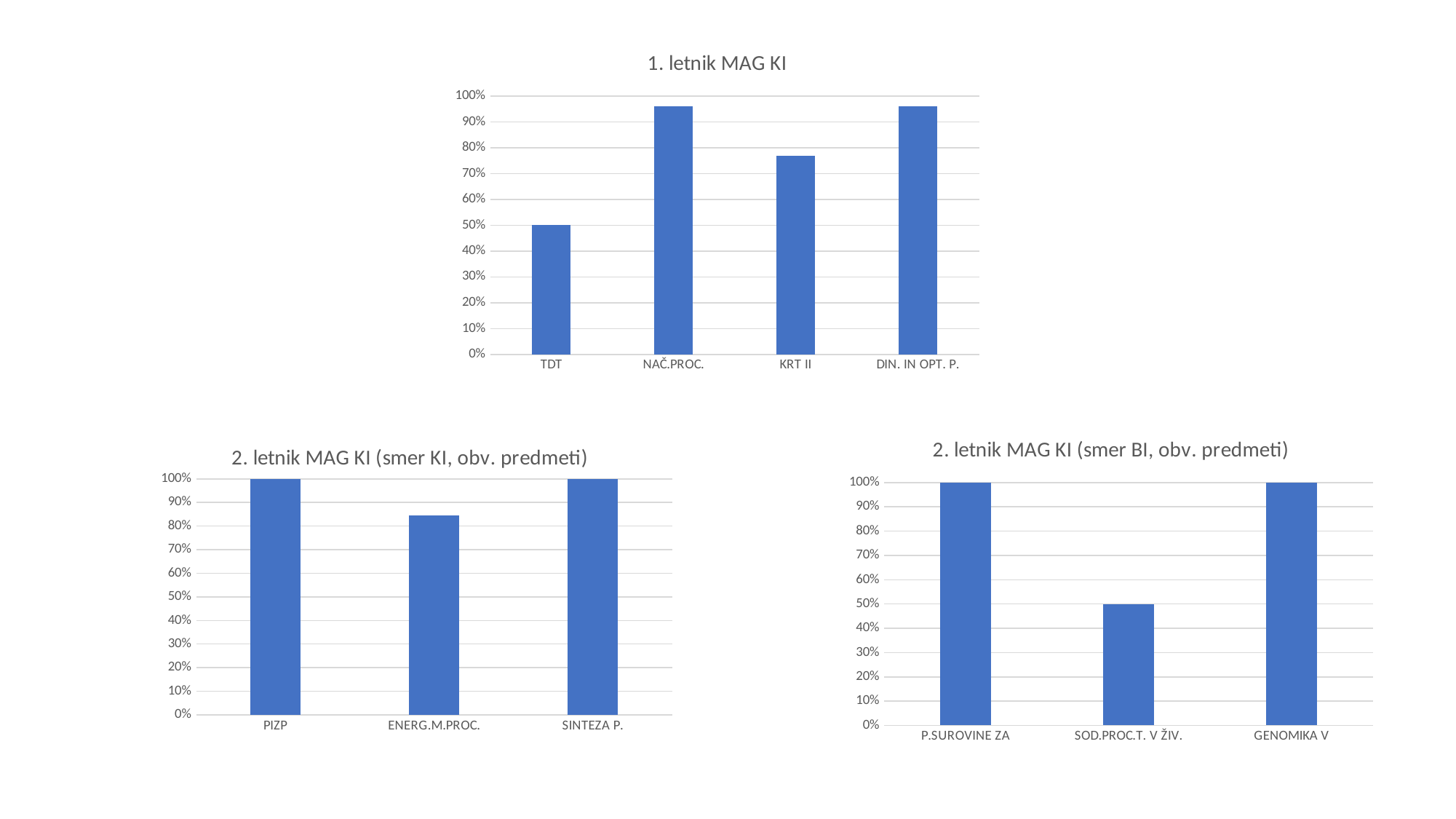
In the chart titled "1. letnik MAG KI", which is larger, the value for KRT II or the value for NAČ.PROC.? NAČ.PROC. In the chart titled "2. letnik MAG KI (smer KI, obv. predmeti)", which category has the lowest value? ENERG.M.PROC. In the chart titled "2. letnik MAG KI (smer BI, obv. predmeti)", what is the value for SOD.PROC.T. V ŽIV.? 50% In the chart titled "1. letnik MAG KI", how many categories are plotted? 4 In the chart titled "1. letnik MAG KI", what is the value for TDT? 50% In the chart titled "2. letnik MAG KI (smer KI, obv. predmeti)", how many categories are plotted? 3 In the chart titled "2. letnik MAG KI (smer KI, obv. predmeti)", what is the value for PIZP? 100% In the chart titled "1. letnik MAG KI", which category has the lowest value? TDT In the chart titled "2. letnik MAG KI (smer KI, obv. predmeti)", is the value for ENERG.M.PROC. greater or less than 80%? greater In the chart titled "1. letnik MAG KI", what kind of chart is shown? bar chart In the chart titled "1. letnik MAG KI", is the value for KRT II greater or less than 80%? less In the chart titled "2. letnik MAG KI (smer BI, obv. predmeti)", what is the difference between the value for P.SUROVINE ZA and the value for SOD.PROC.T. V ŽIV.? 50%